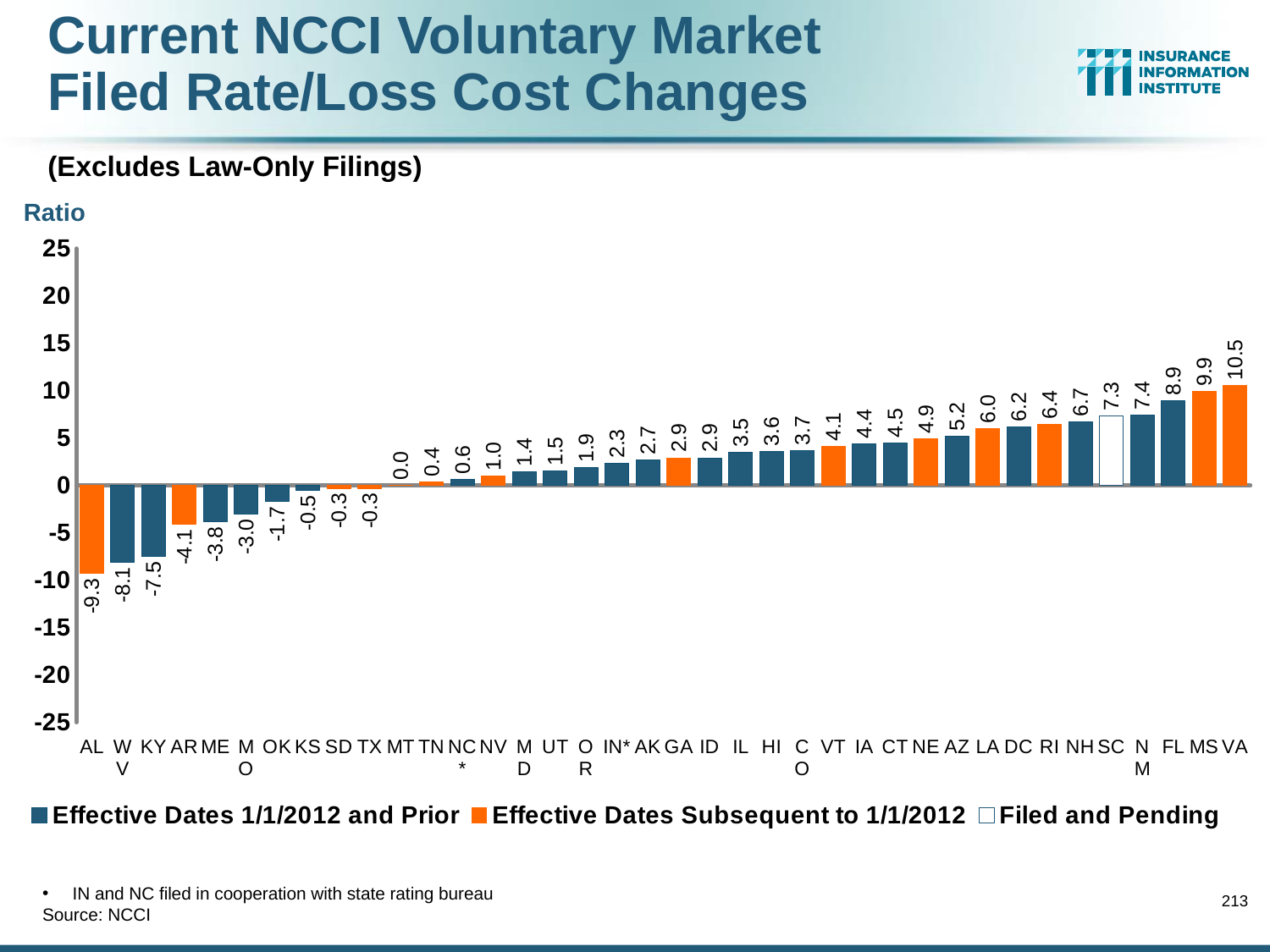
What is the value for AL? -9.3 Which is larger, the value for KY or the value for WV? KY Which state has the lowest value? AL What is the value for SC? 7.3 What is the difference between the values for VA and AL? 19.8 How many states are shown on the x axis? 38 What is the difference between the values for MS and FL? 1.0 What kind of chart is this? Bar chart Which state's bar is shown as Filed and Pending? SC Which state has the highest value? VA How many series does the legend list? 3 What is the value for VA? 10.5